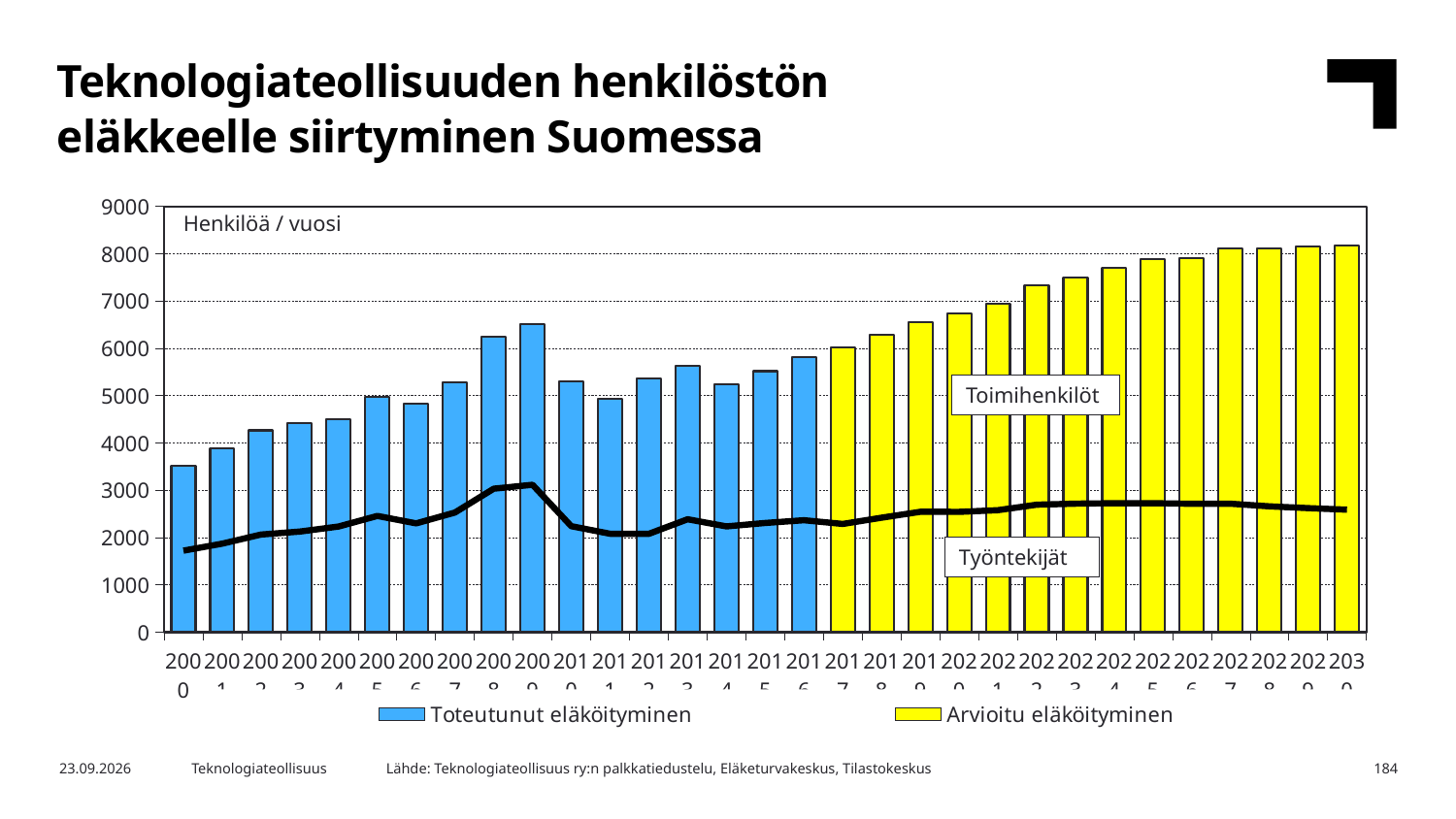
What colour are the 'Arvioitu eläköityminen' bars? yellow Which year has the lowest bar? 2000 Is the bar for 2020 greater or less than 7000? less How many years are shown on the x axis? 31 What kind of chart is shown on the slide? combination bar and line chart Is the bar for 2000 greater or less than 4000? less Is the bar for 2030 greater or less than 8000? greater Do the bar values rise or fall from 2017 to 2030? rise Which bar is taller, 2009 or 2010? 2009 Among the blue 'Toteutunut eläköityminen' bars, which year is highest? 2009 How many series does the legend list? 2